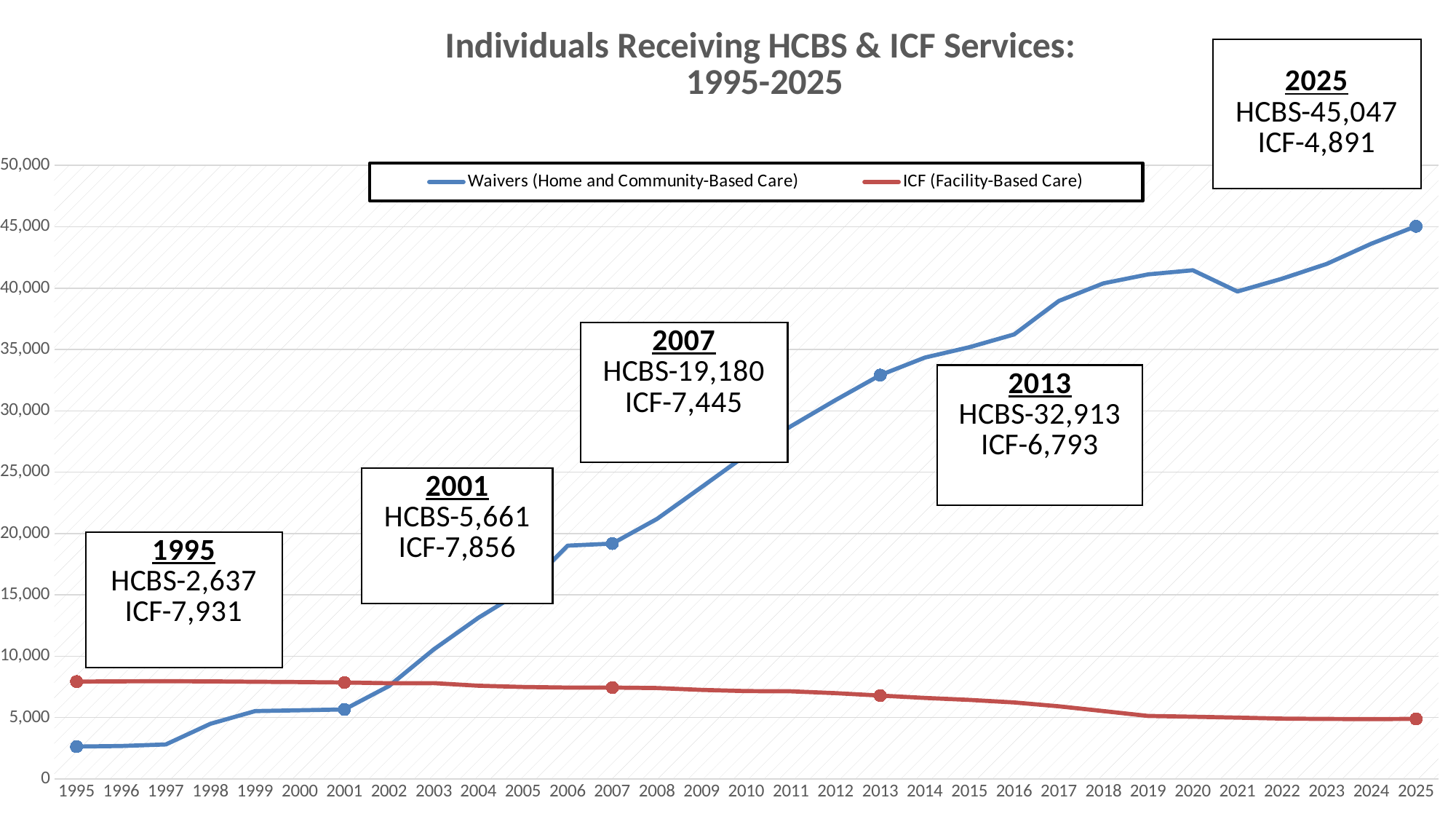
What is the ICF value shown for 1995? 7,931 Is the Waivers (Home and Community-Based Care) value for 2017 greater or less than 35,000? greater What is the title of the chart? Individuals Receiving HCBS & ICF Services: 1995-2025 In which year does the Waivers (Home and Community-Based Care) line reach its highest value? 2025 What kind of chart is shown on the slide? Line chart In 2013, how much larger is the HCBS value than the ICF value? 26,120 What is the HCBS value shown for 2025? 45,047 What is the HCBS value shown for 2007? 19,180 In 2001, which is larger, the HCBS value or the ICF value? ICF Does the ICF (Facility-Based Care) line rise or fall from 1995 to 2025? Fall By how much did the ICF value decrease from 1995 to 2025? 3,040 How many series does the legend list? 2